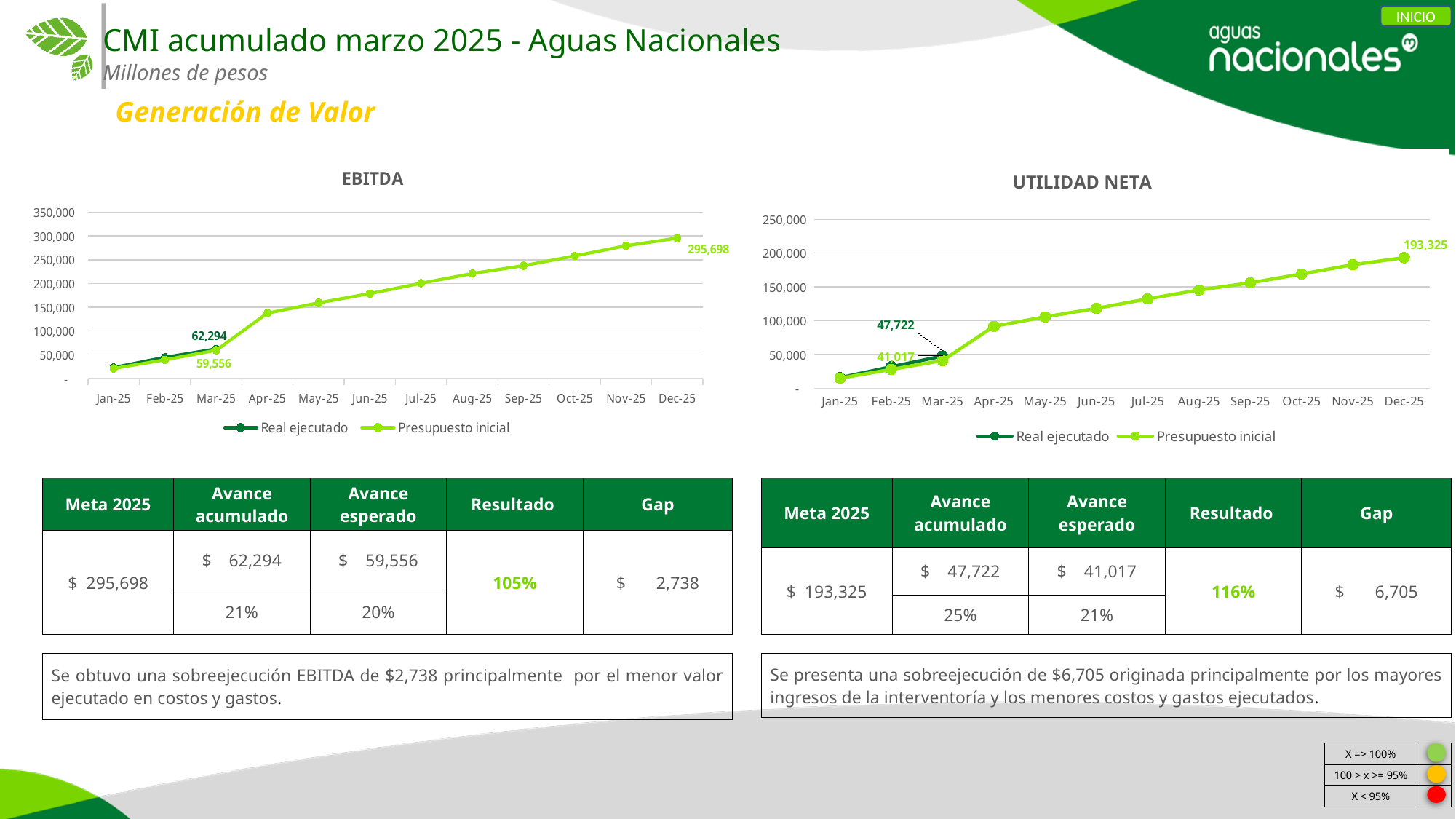
In the UTILIDAD NETA chart, what is the value of Real ejecutado at Mar-25? 47,722 In the UTILIDAD NETA chart, what is the difference between Real ejecutado and Presupuesto inicial at Mar-25? 6,705 What kind of chart is the UTILIDAD NETA chart? Line chart In the UTILIDAD NETA chart, which series is higher at Mar-25, Real ejecutado or Presupuesto inicial? Real ejecutado In the EBITDA chart, what is the value of Presupuesto inicial at Dec-25? 295,698 In the EBITDA chart, is the Presupuesto inicial value for Jun-25 greater or less than 150,000? greater In the UTILIDAD NETA chart, what is the value of Presupuesto inicial at Dec-25? 193,325 How many series does the legend of the UTILIDAD NETA chart list? 2 In the EBITDA chart, what is the value of Real ejecutado at Mar-25? 62,294 How many months are shown on the x axis of the EBITDA chart? 12 In the EBITDA chart, what is the value of Presupuesto inicial at Mar-25? 59,556 In the EBITDA chart, what is the difference between Real ejecutado and Presupuesto inicial at Mar-25? 2,738